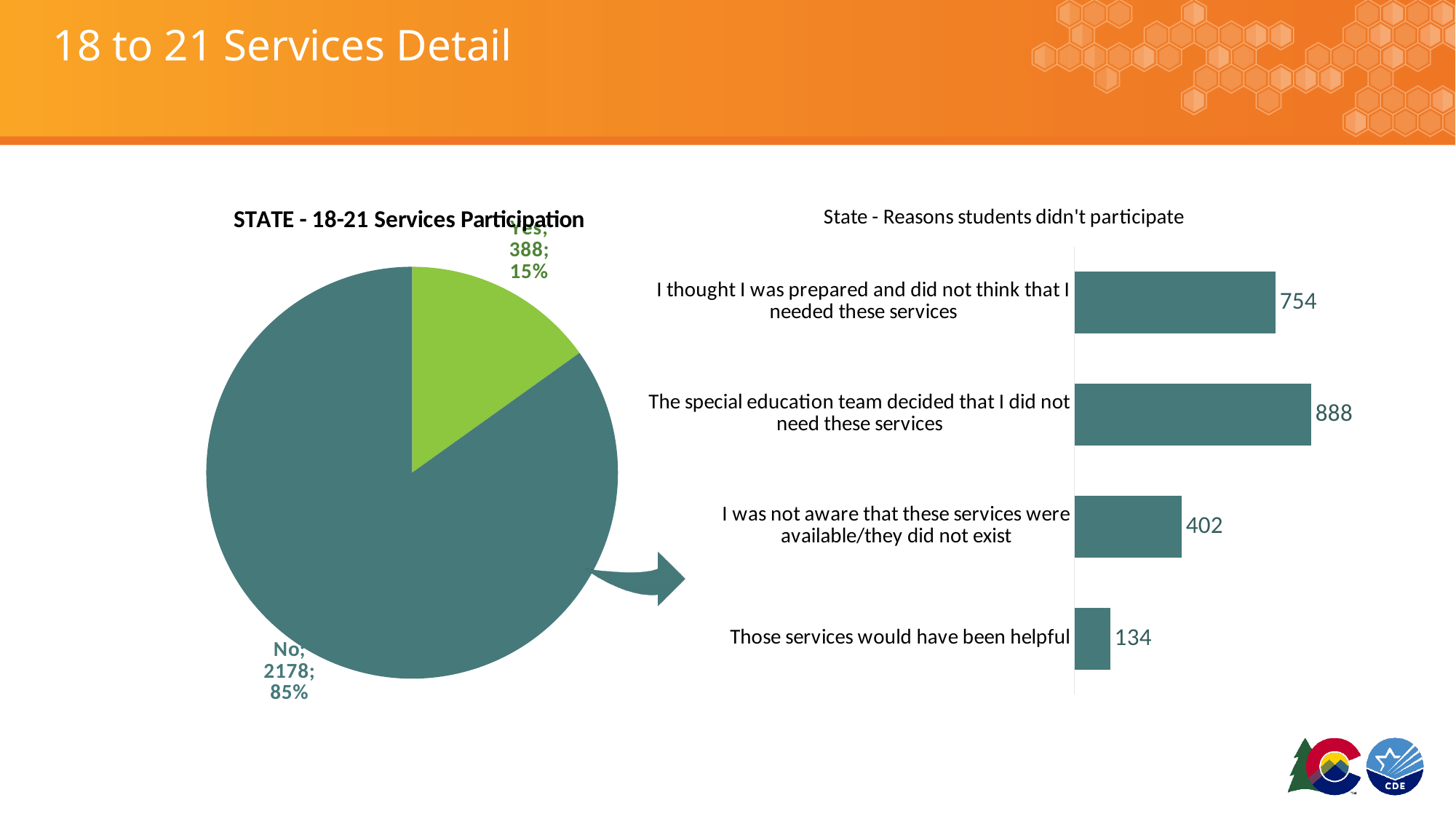
What kind of chart is 'State - Reasons students didn't participate'? Bar chart In the 'State - Reasons students didn't participate' chart, which is larger: 'I was not aware that these services were available/they did not exist' or 'I thought I was prepared and did not think that I needed these services'? I thought I was prepared and did not think that I needed these services In the 'State - Reasons students didn't participate' chart, which reason has the lowest value? Those services would have been helpful In the 'State - Reasons students didn't participate' chart, what is the difference between the values for 'The special education team decided that I did not need these services' and 'I thought I was prepared and did not think that I needed these services'? 134 In the 'State - Reasons students didn't participate' chart, what is the value for 'Those services would have been helpful'? 134 In the 'State - Reasons students didn't participate' chart, which reason has the highest value? The special education team decided that I did not need these services In the 'STATE - 18-21 Services Participation' pie chart, what is the value for 'No'? 2178 What kind of chart is 'STATE - 18-21 Services Participation'? Pie chart In the 'STATE - 18-21 Services Participation' pie chart, what is the count for 'Yes'? 388 How many reasons are shown in the 'State - Reasons students didn't participate' chart? 4 In the 'STATE - 18-21 Services Participation' pie chart, what percentage share does 'Yes' have? 15% In the 'State - Reasons students didn't participate' chart, what is the value for 'The special education team decided that I did not need these services'? 888